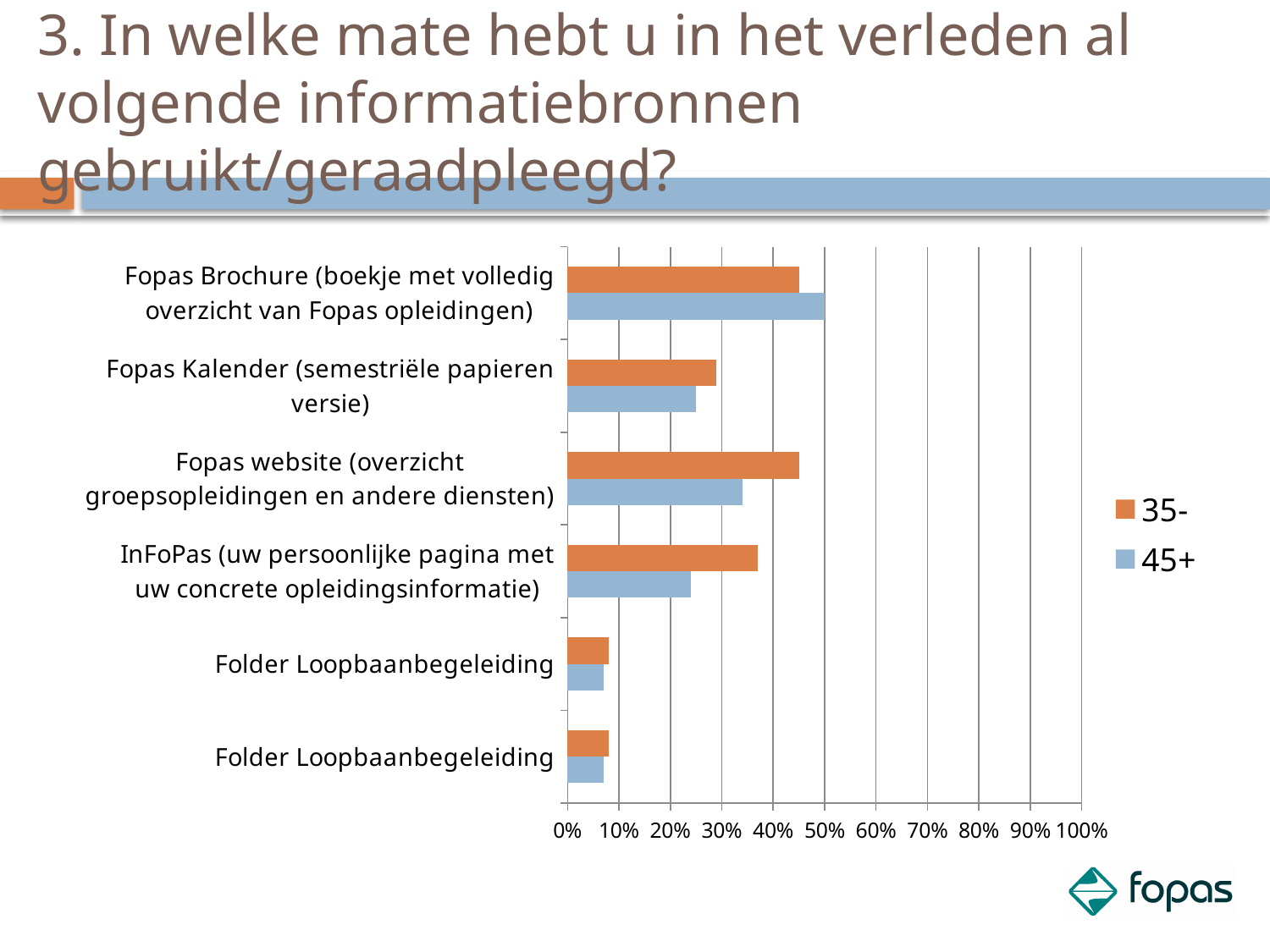
Is the 35- value for Folder Loopbaanbegeleiding greater or less than 10%? less Is the 35- value for Fopas Brochure (boekje met volledig overzicht van Fopas opleidingen) greater or less than 40%? greater For Fopas website (overzicht groepsopleidingen en andere diensten), which series has the larger value, 35- or 45+? 35- How many categories are plotted on the chart? 6 Which category has the highest value for the 45+ series? Fopas Brochure (boekje met volledig overzicht van Fopas opleidingen) Is the 45+ value for Fopas Kalender (semestriële papieren versie) greater or less than 20%? greater How many series does the legend list? 2 What are the two series named in the legend? 35- and 45+ What kind of chart is shown on the slide? bar chart For InFoPas (uw persoonlijke pagina met uw concrete opleidingsinformatie), which series has the larger value, 35- or 45+? 35- For Fopas Brochure (boekje met volledig overzicht van Fopas opleidingen), which series has the larger value, 35- or 45+? 45+